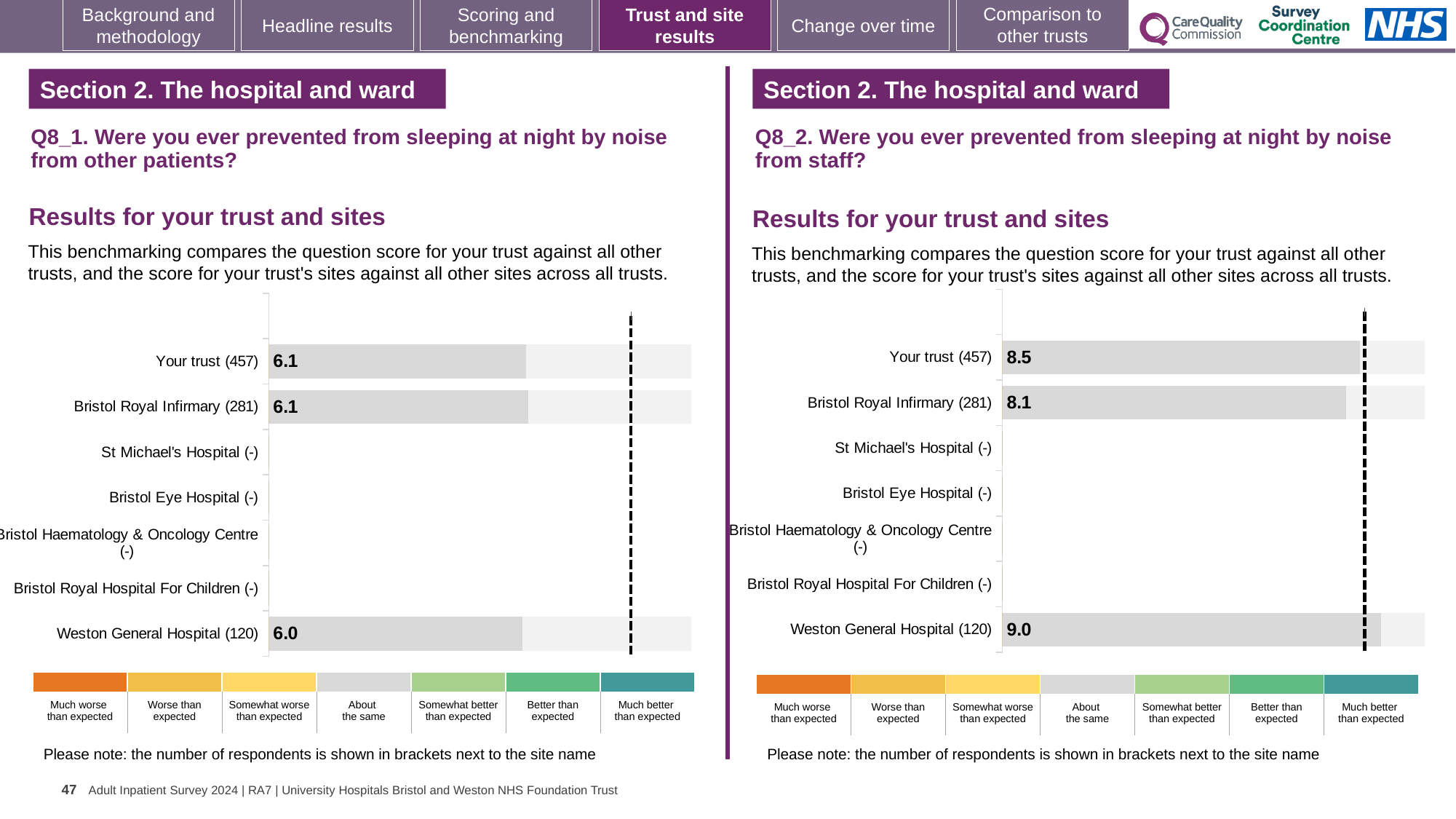
On the Q8_1 chart (noise from other patients), what is the difference between the Your trust score and the Weston General Hospital score? 0.1 On the Q8_2 chart (noise from staff), which is larger: the score for Your trust or the score for Bristol Royal Infirmary? Your trust On the Q8_2 chart (noise from staff), which site or trust row has the lowest score? Bristol Royal Infirmary On the Q8_1 chart (noise from other patients), what is the score for Weston General Hospital? 6.0 On the Q8_1 chart (noise from other patients), what is the score for Your trust? 6.1 On the Q8_1 chart (noise from other patients), how many respondents are shown in brackets for Bristol Royal Infirmary? 281 On the Q8_2 chart (noise from staff), what is the score for Bristol Royal Infirmary? 8.1 On the Q8_2 chart (noise from staff), what is the score for Weston General Hospital? 9.0 What kind of chart is used on the Q8_2 chart (noise from staff)? Bar chart On the Q8_2 chart (noise from staff), which site or trust row has the highest score? Weston General Hospital On the Q8_2 chart (noise from staff), what is the difference between the Weston General Hospital score and the Bristol Royal Infirmary score? 0.9 How many site or trust rows are listed on the Q8_1 chart (noise from other patients)? 7